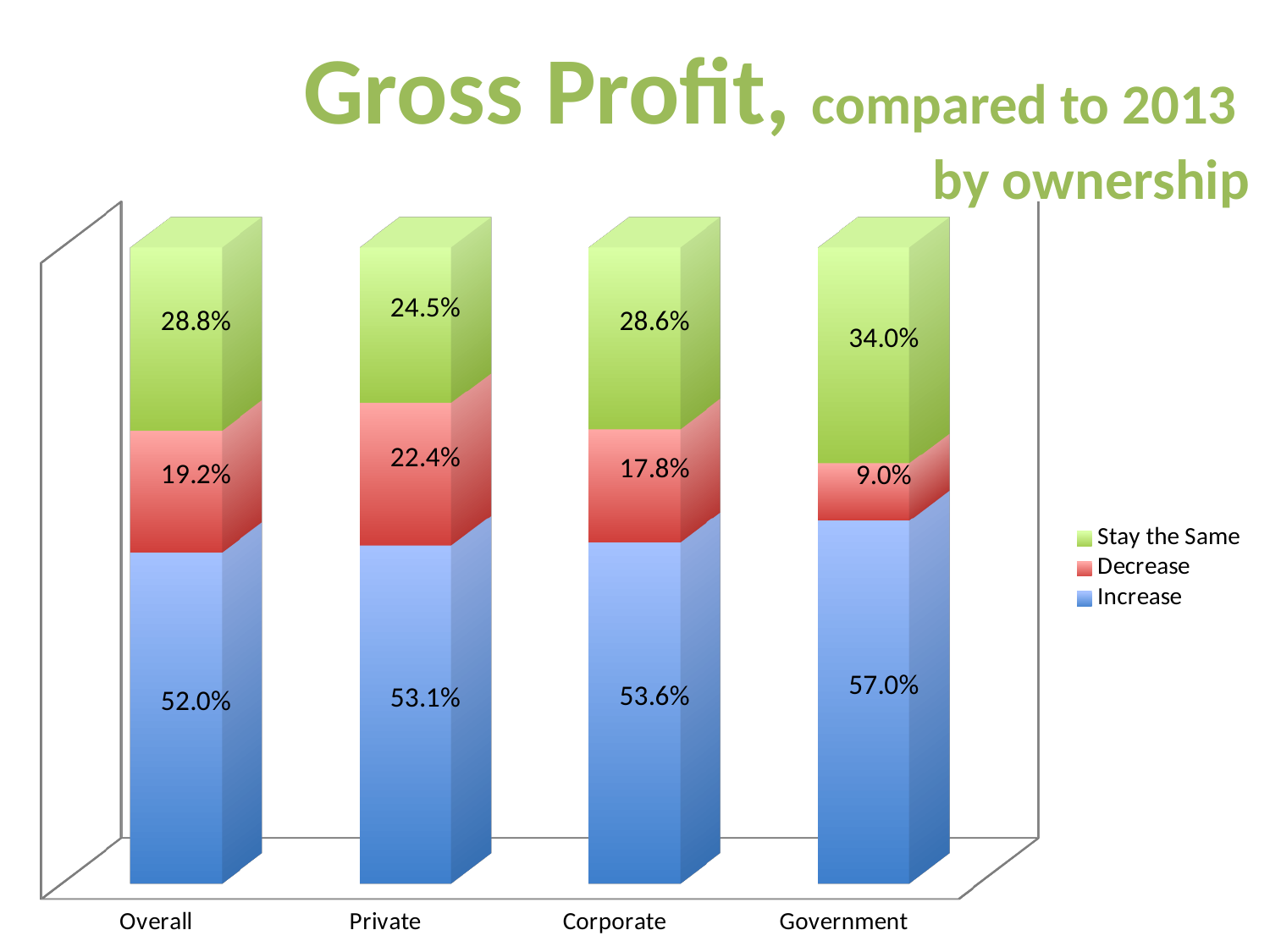
Which ownership category has the lowest Decrease value? Government What is the Decrease value for Private? 22.4% Which is larger, the Decrease value for Private or the Decrease value for Corporate? Private What is the difference between the Increase values for Government and Overall? 5.0% Which ownership category has the highest Increase value? Government What is the Increase value for Government? 57.0% What is the Stay the Same value for Corporate? 28.6% What kind of chart is shown on the slide? Stacked bar chart What is the Decrease value for Overall? 19.2% Which ownership category has the lowest Stay the Same value? Private How many series does the legend list? 3 How many ownership categories are shown on the x axis? 4